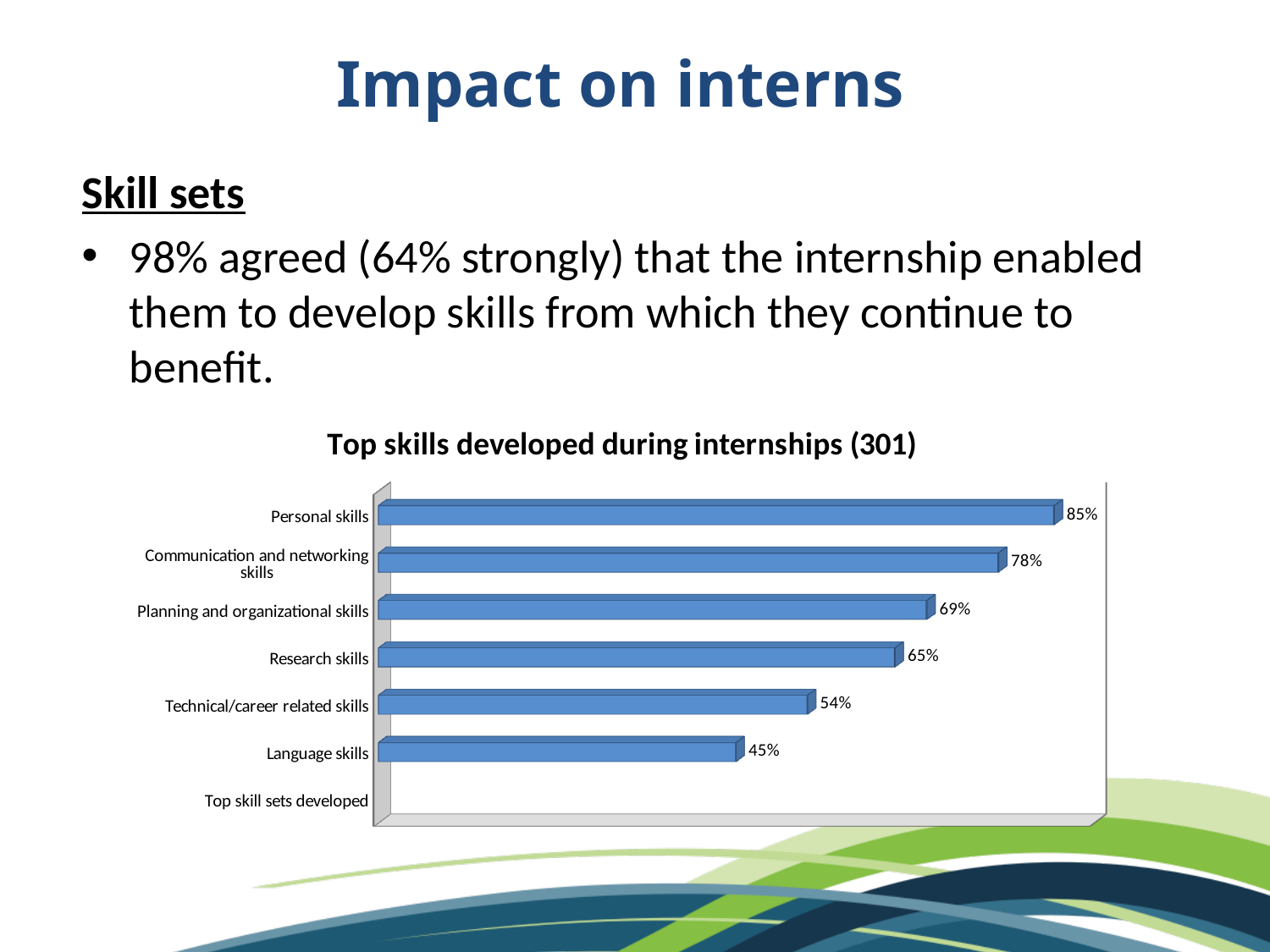
How many bars are plotted in the chart? 6 What kind of chart is shown? Bar chart What is the value for Research skills? 65% What is the value for Communication and networking skills? 78% What is the value for Language skills? 45% What is the value for Technical/career related skills? 54% Which is larger, the value for Planning and organizational skills or the value for Research skills? Planning and organizational skills What is the title of the chart? Top skills developed during internships (301) What is the difference between the values for Personal skills and Language skills? 40 percentage points What is the value for Personal skills? 85% Which skill has the highest value? Personal skills Which skill with a plotted bar has the lowest value? Language skills